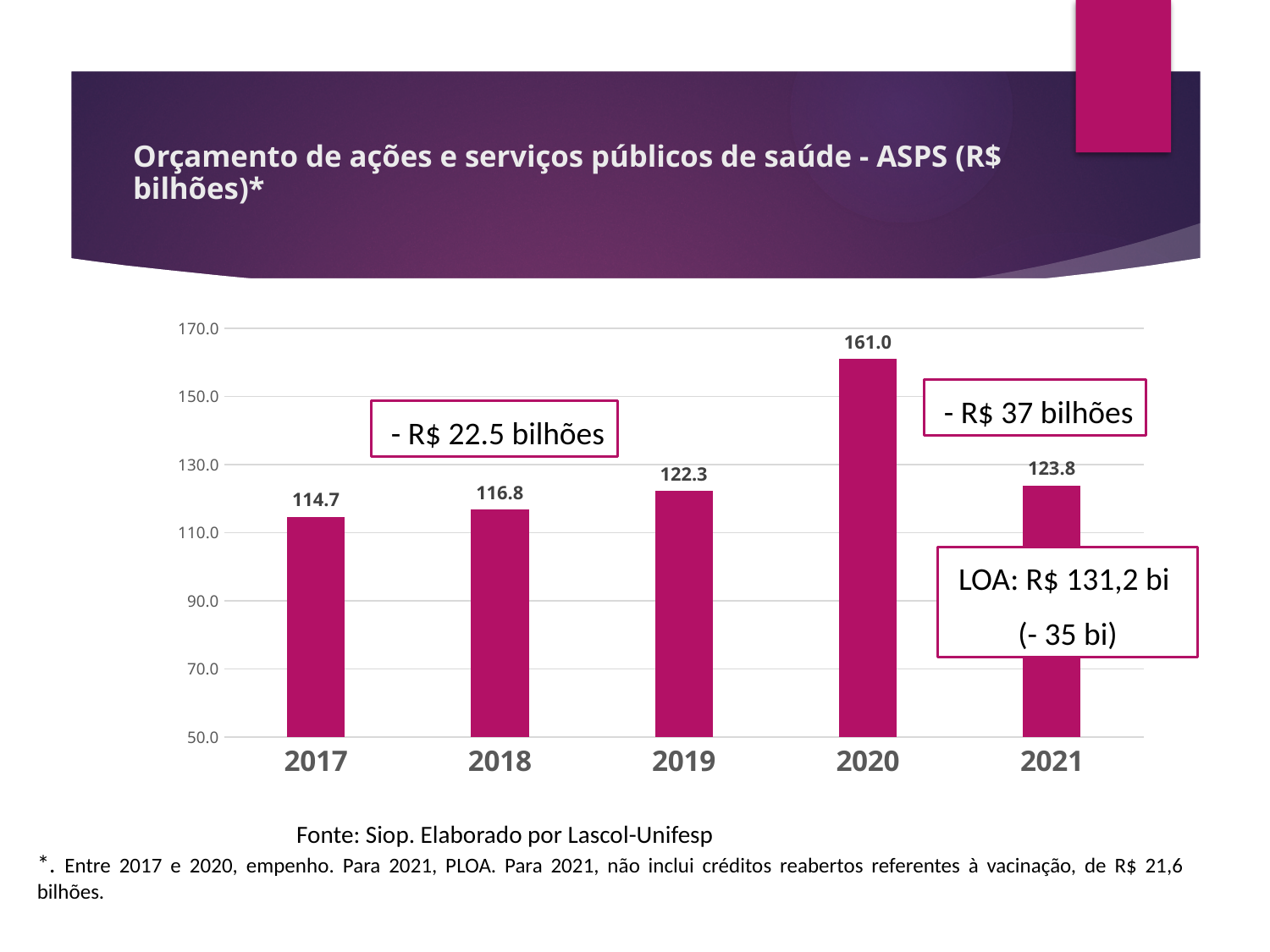
What is the value for 2020? 161.0 What kind of chart is shown on the slide? bar chart Is the value for 2020 greater or less than 150.0? greater Do the values rise or fall from 2017 to 2020? rise What is the difference between the values for 2019 and 2018? 5.5 Which year has the lowest value? 2017 What is the difference between the values for 2020 and 2021? 37.2 Which is larger, the value for 2019 or the value for 2021? 2021 What is the value for 2017? 114.7 How many years are shown on the x axis? 5 Which year has the highest value? 2020 What is the value for 2021? 123.8